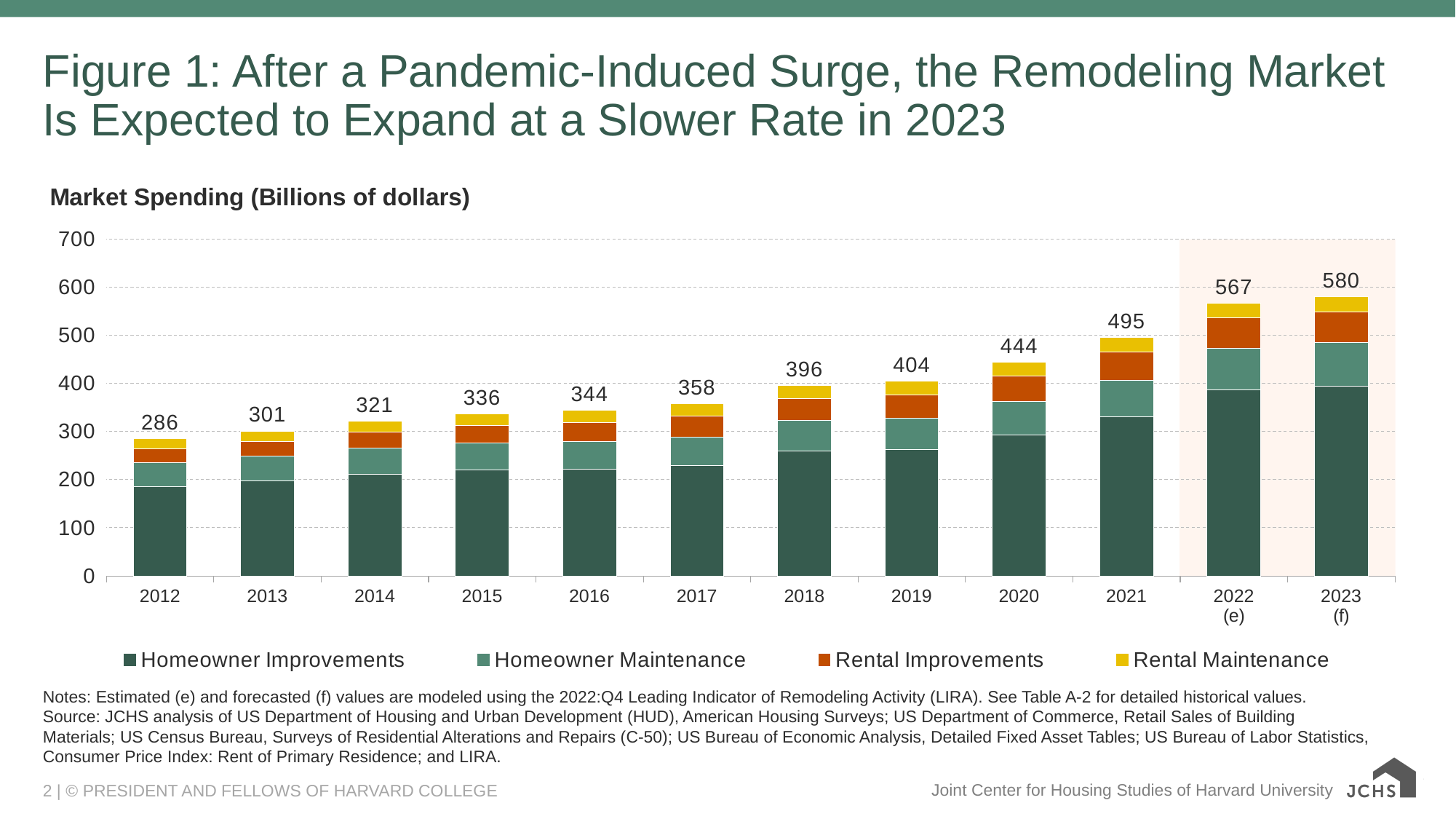
What is the total market spending forecast for 2023 (f)? 580 How many series does the legend list? 4 What is the difference between the total market spending in 2022 (e) and 2021? 72 Which year has higher total market spending, 2018 or 2019? 2019 What is the total market spending shown for 2020? 444 Which year has the lowest total market spending? 2012 Is the Homeowner Improvements value for 2021 greater or less than 300? greater What is the difference between the total market spending in 2023 (f) and 2012? 294 Which year has the highest total market spending? 2023 (f) What kind of chart is shown on the slide? Stacked bar chart How many years are shown on the x axis? 12 What is the total market spending shown for 2012? 286